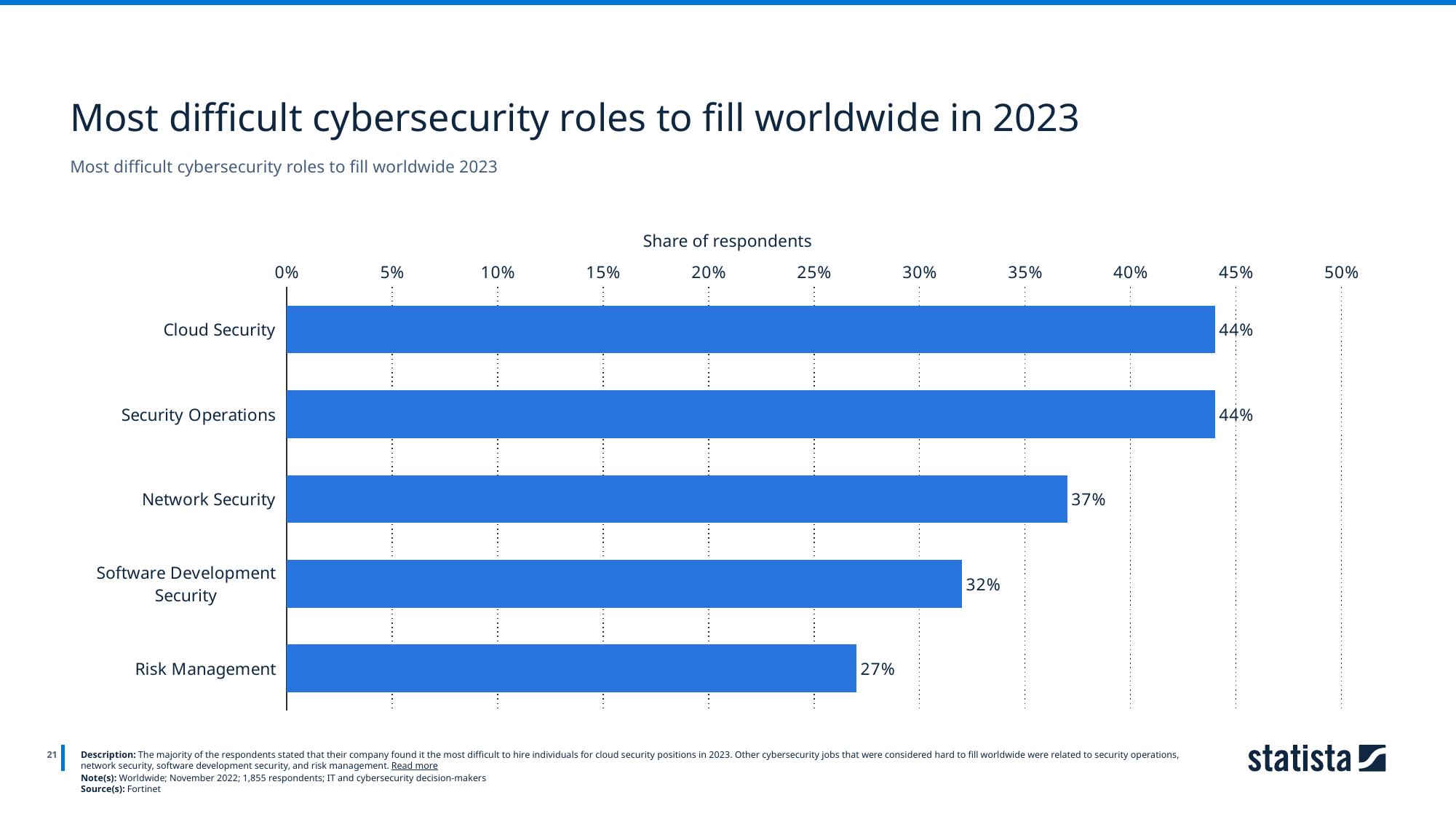
What is the difference between the shares for Cloud Security and Software Development Security? 12% Which is larger, the share for Network Security or the share for Software Development Security? Network Security Is the value for Risk Management greater or less than 30%? less What is the difference between the shares for Network Security and Risk Management? 10% What is the share of respondents for Software Development Security? 32% What is the share of respondents for Network Security? 37% How many categories are shown in the chart? 5 What is the share of respondents for Risk Management? 27% Which category has the lowest share of respondents? Risk Management What is the share of respondents for Cloud Security? 44% What kind of chart is shown on the slide? bar chart What is the label of the value axis? Share of respondents